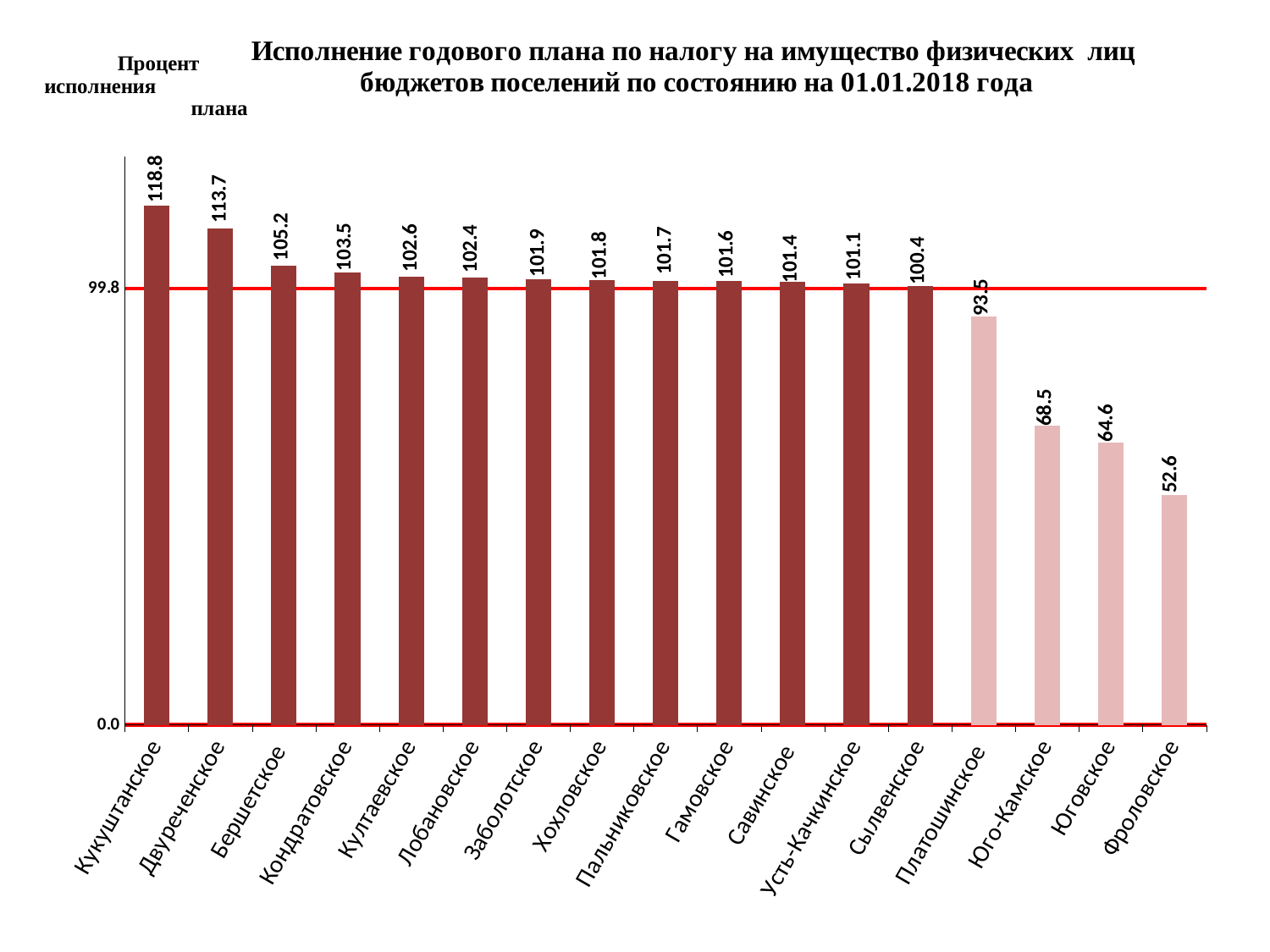
What is the difference between the values for Кукуштанское and Двуреченское? 5.1 Is the value for Платошинское greater or less than 99.8? less How many categories are shown on the x axis? 17 What is the value for Платошинское? 93.5 What is the value for Юго-Камское? 68.5 Which category has the lowest value? Фроловское What value is marked by the horizontal red line across the chart? 99.8 What is the value for Кукуштанское? 118.8 Which is larger, the value for Бершетское or the value for Кондратовское? Бершетское What kind of chart is shown on the slide? bar chart Which category has the highest value? Кукуштанское What is the difference between the values for Юговское and Фроловское? 12.0